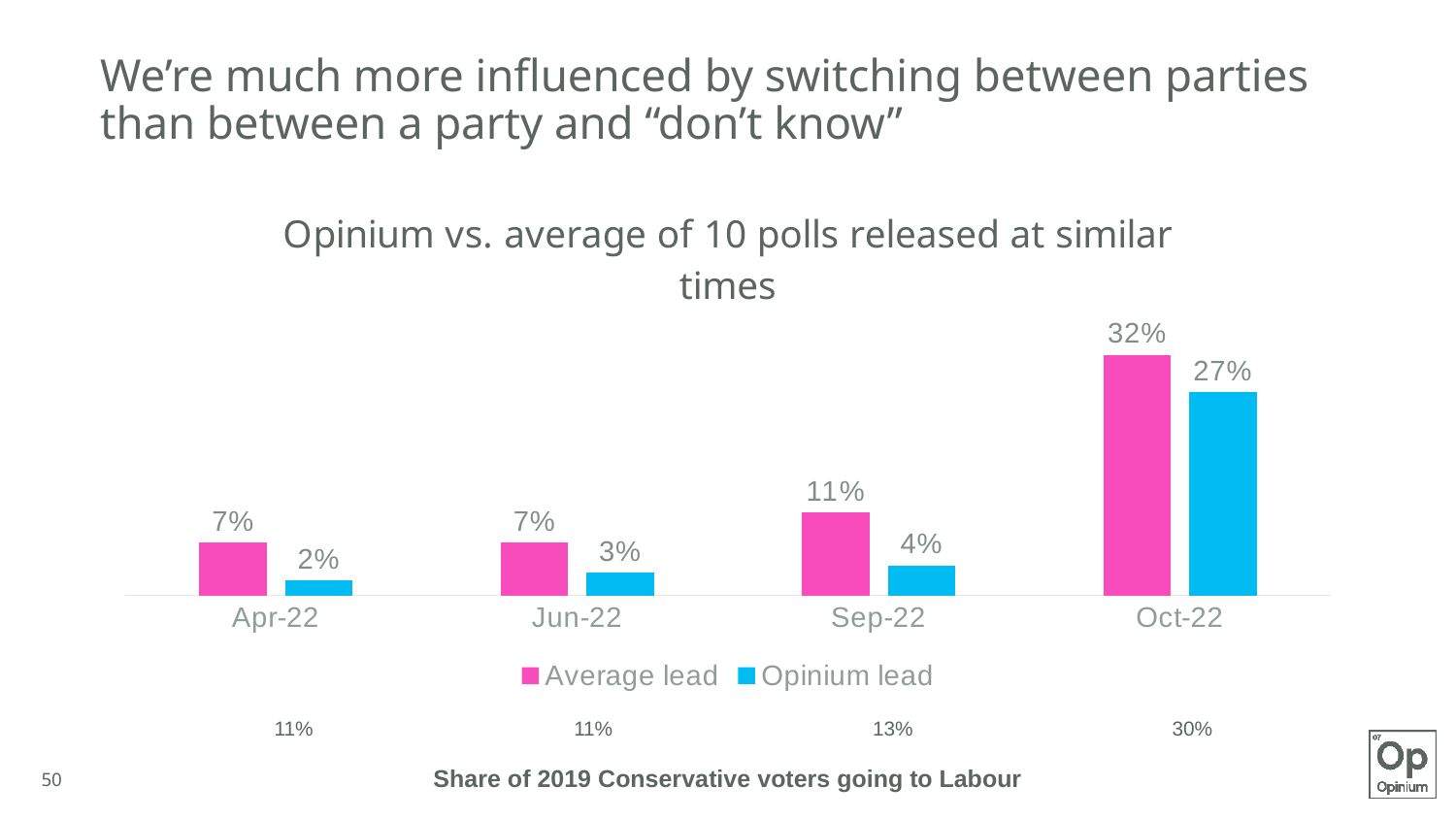
What is the Opinium lead value for Apr-22? 2% What is the Average lead value for Oct-22? 32% What is the difference between the Average lead and the Opinium lead in Oct-22? 5% Which month has the lowest Opinium lead? Apr-22 How many series does the legend list? 2 What is the Opinium lead value for Sep-22? 4% Which is larger in Jun-22, the Average lead or the Opinium lead? Average lead How many months are shown on the x axis? 4 Does the Opinium lead rise or fall from Apr-22 to Oct-22? Rise Which month has the highest Average lead? Oct-22 What kind of chart is shown on the slide? Bar chart What is the difference between the Average lead and the Opinium lead in Sep-22? 7%